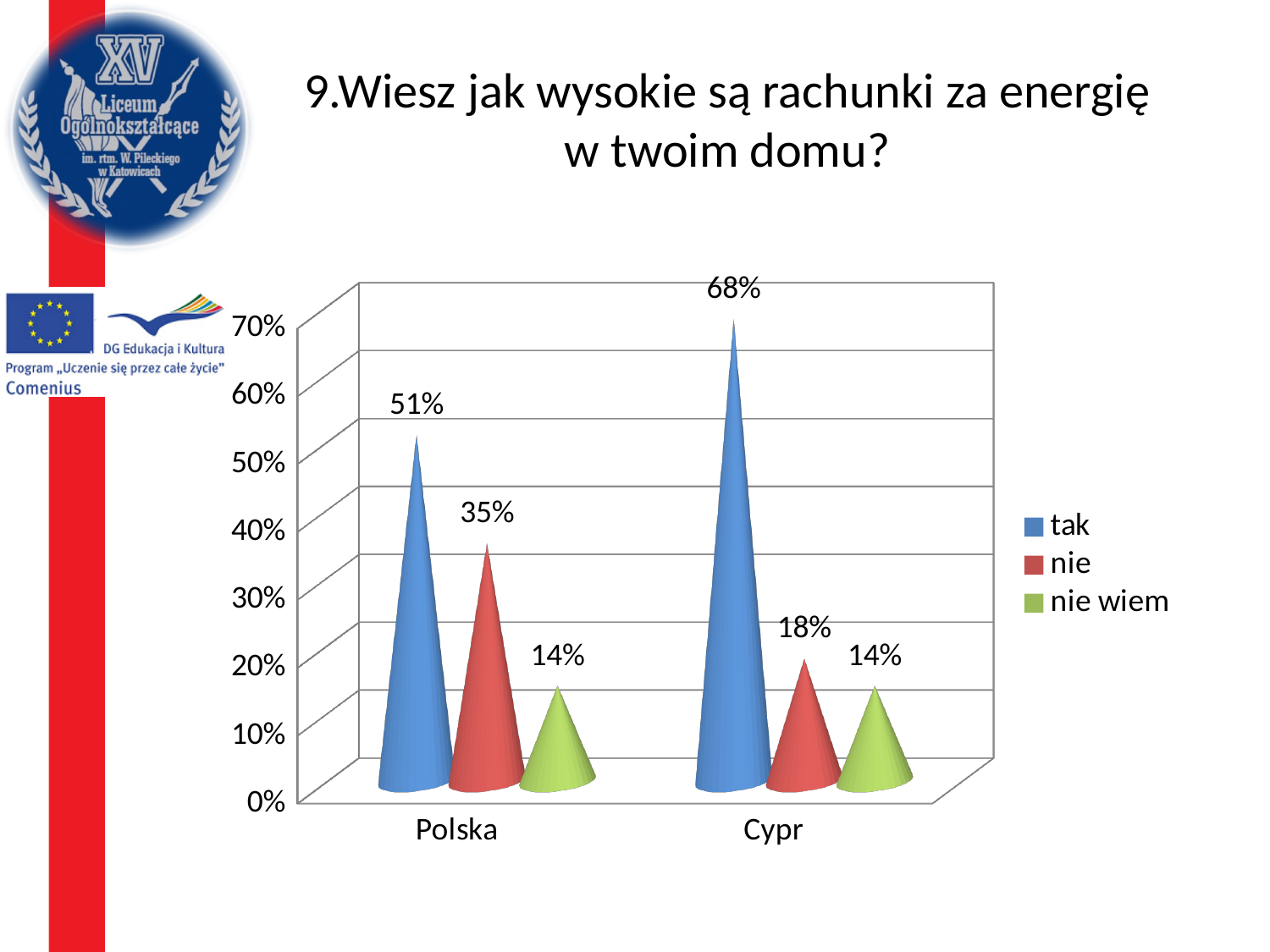
What kind of chart is shown on the slide? bar chart Which series has the lowest value for Cypr? nie wiem How many series does the legend list? 3 Which is larger: "nie" for Polska or "nie" for Cypr? nie for Polska How many categories are shown on the x axis? 2 What is the value for "nie" for Cypr? 18% What is the difference between "nie" for Polska and "nie" for Cypr? 17% What is the value for "nie wiem" for Polska? 14% Which country has the highest value for "tak"? Cypr What is the value for "tak" for Cypr? 68% What is the value for "tak" for Polska? 51% What is the difference between the "tak" values for Cypr and Polska? 17%